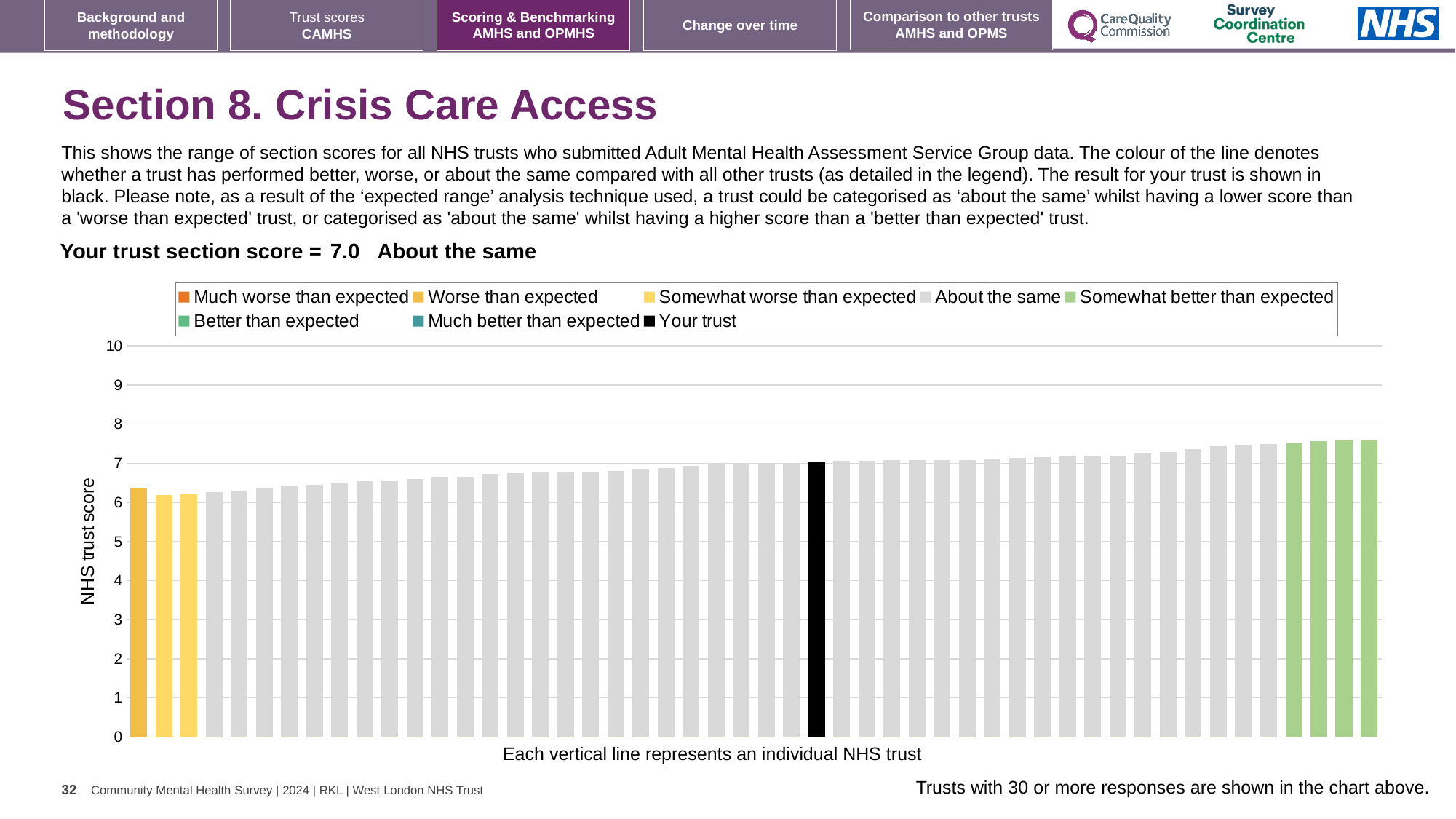
How many bars are coloured green (somewhat better than expected) in the chart? 4 What colour does the legend use for 'Your trust'? black Do the bar values rise or fall from left to right along the x axis? rise Which is taller: the black 'Your trust' bar or the leftmost bar? the black 'Your trust' bar Is the value of the tallest bar in the chart greater or less than 8? less What is the title of the vertical axis? NHS trust score Is the value of the black 'Your trust' bar greater or less than 5? greater What kind of chart is shown on the slide? bar chart What is the section score for your trust shown on the slide? 7.0 How many entries does the chart legend list? 8 Is the value of the leftmost bar in the chart greater or less than 6? greater Which category is your trust placed in for this section? About the same